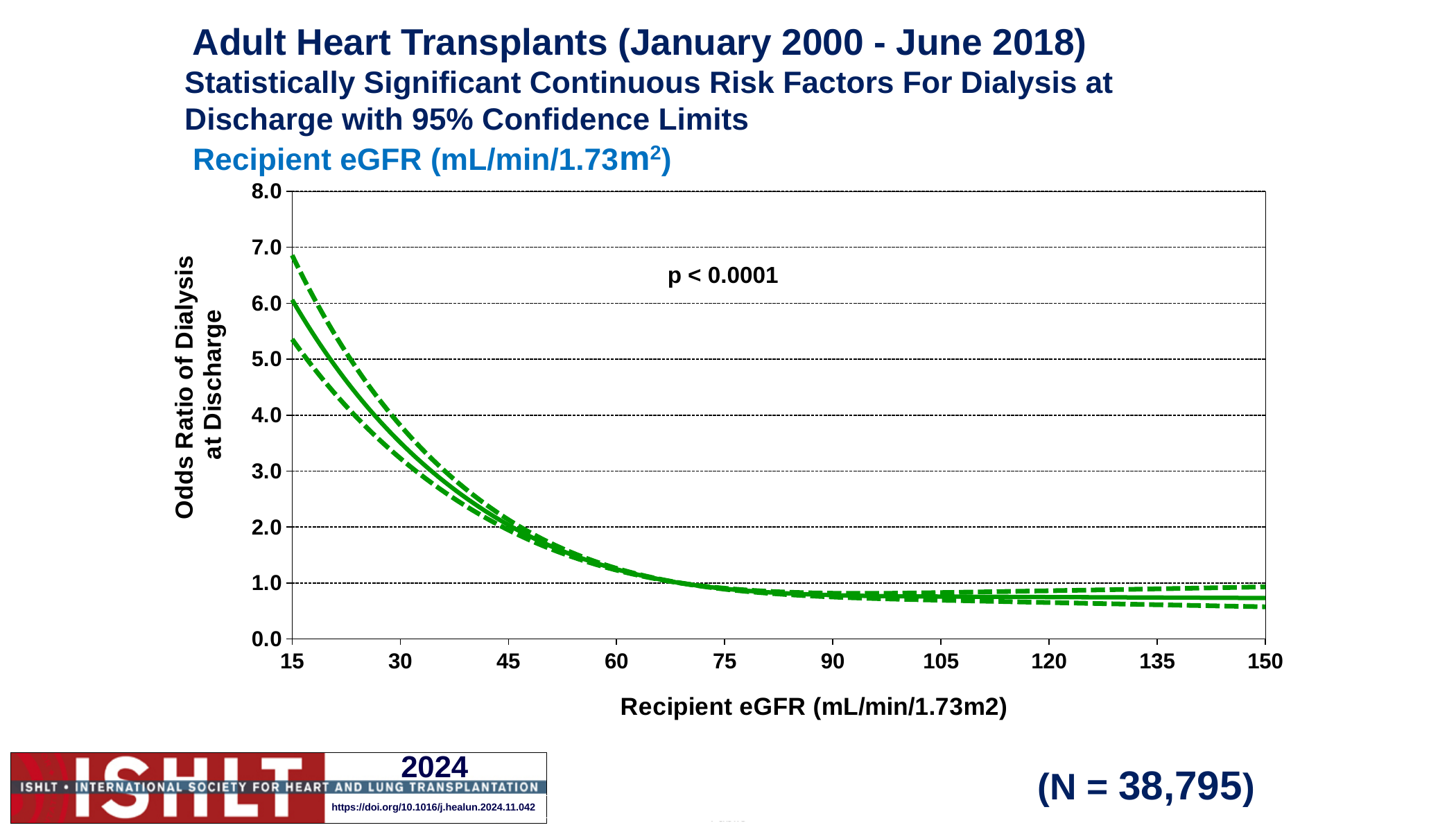
Is the odds ratio (solid line) at a recipient eGFR of 30 greater or less than 3.0? greater Is the lower 95% confidence limit (lower dashed line) at a recipient eGFR of 15 greater or less than 6.0? less How many tick labels are shown on the x axis of the chart? 10 What kind of chart is shown on the slide? line chart What is the label of the y axis of the chart? Odds Ratio of Dialysis at Discharge Is the odds ratio (solid line) at a recipient eGFR of 150 greater or less than 1.0? less Does the odds ratio of dialysis at discharge rise or fall as recipient eGFR increases along the x axis? fall How many lines are plotted on the chart? 3 What p-value is printed on the chart? p < 0.0001